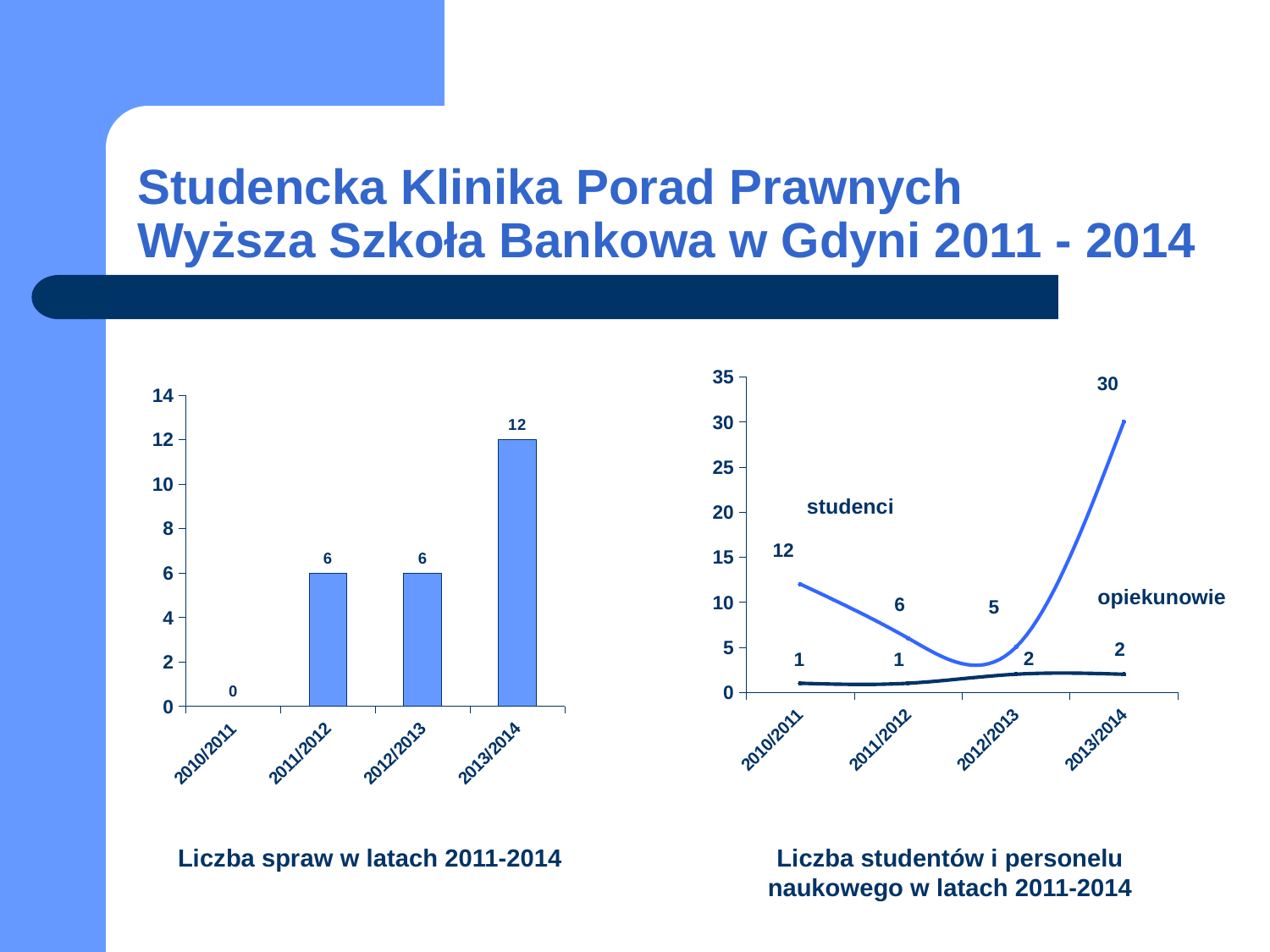
In the right chart (Liczba studentów i personelu naukowego w latach 2011-2014), what is the value for opiekunowie in 2012/2013? 2 In the right chart (Liczba studentów i personelu naukowego w latach 2011-2014), in which year is the studenci value lowest? 2012/2013 What kind of chart is the right chart (Liczba studentów i personelu naukowego w latach 2011-2014)? line chart In the right chart (Liczba studentów i personelu naukowego w latach 2011-2014), which is larger in 2010/2011: studenci or opiekunowie? studenci In the right chart (Liczba studentów i personelu naukowego w latach 2011-2014), what is the difference between studenci and opiekunowie in 2013/2014? 28 In the left chart (Liczba spraw w latach 2011-2014), what is the value for 2010/2011? 0 In the left chart (Liczba spraw w latach 2011-2014), what is the value for 2013/2014? 12 What kind of chart is the left chart (Liczba spraw w latach 2011-2014)? bar chart In the left chart (Liczba spraw w latach 2011-2014), what is the difference between the values for 2013/2014 and 2012/2013? 6 In the right chart (Liczba studentów i personelu naukowego w latach 2011-2014), what is the value for studenci in 2013/2014? 30 In the left chart (Liczba spraw w latach 2011-2014), which year has the highest value? 2013/2014 In the left chart (Liczba spraw w latach 2011-2014), how many years are shown on the x axis? 4